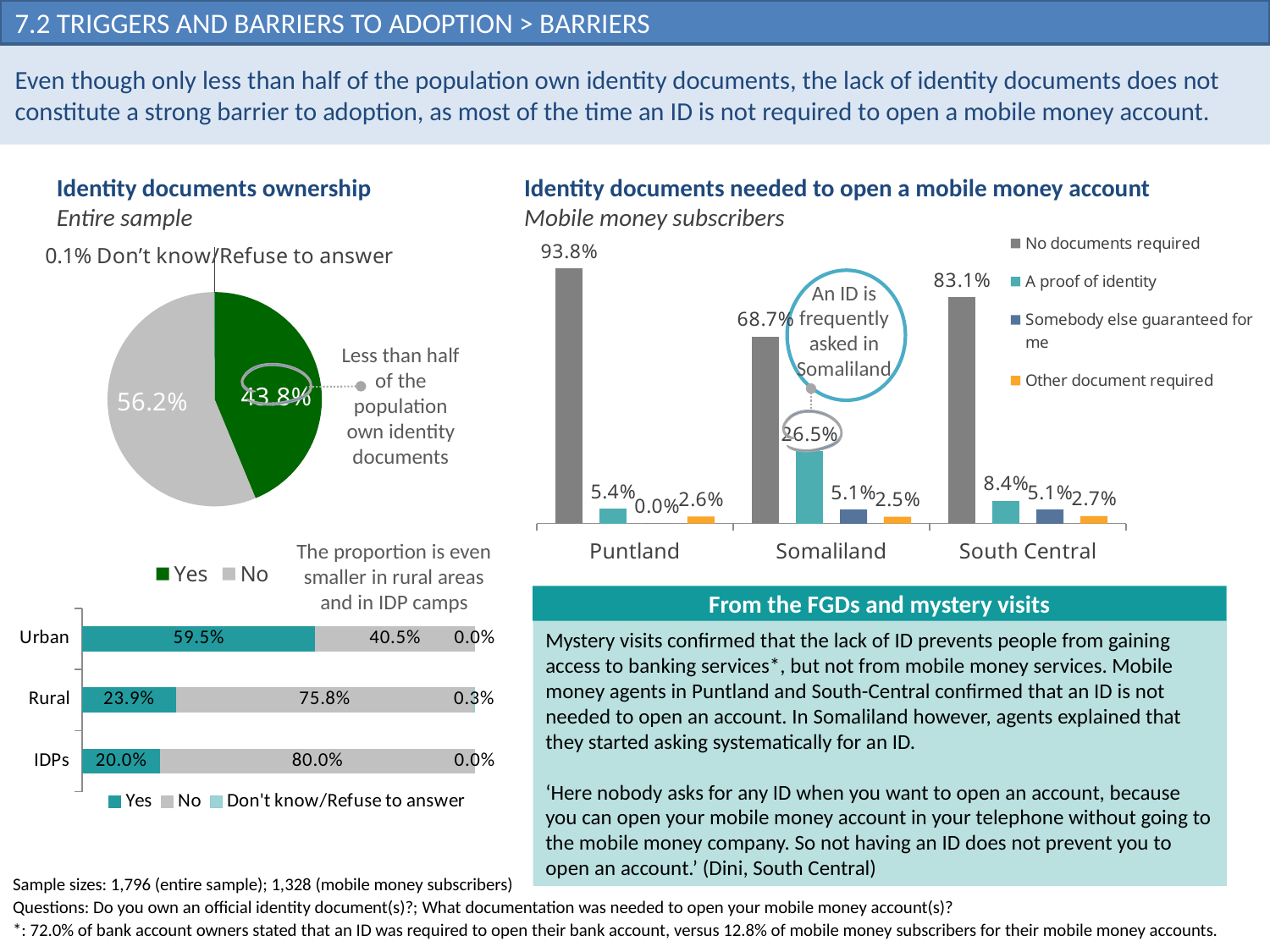
In the stacked bar chart by area (Urban, Rural, IDPs), what is the No value for IDPs? 80.0% In the stacked bar chart by area (Urban, Rural, IDPs), what is the Yes value for Rural? 23.9% In the 'Identity documents needed to open a mobile money account' chart, what is the value for 'A proof of identity' in Somaliland? 26.5% How many series does the legend of the 'Identity documents needed to open a mobile money account' chart list? 4 In the stacked bar chart by area (Urban, Rural, IDPs), which category has the highest Yes value? Urban In the 'Identity documents ownership' pie chart, what percentage answered No? 56.2% In the 'Identity documents ownership' pie chart, what percentage of the entire sample answered Yes? 43.8% In the 'Identity documents needed to open a mobile money account' chart, which region has the highest value for 'No documents required'? Puntland How many categories are shown in the stacked bar chart by area (Urban, Rural, IDPs)? 3 What kind of chart is the 'Identity documents ownership' chart for the entire sample? Pie chart In the 'Identity documents needed to open a mobile money account' chart, what is the difference between Puntland and South Central for 'No documents required'? 10.7 percentage points In the 'Identity documents needed to open a mobile money account' chart, which region has the larger value for 'A proof of identity', Somaliland or South Central? Somaliland